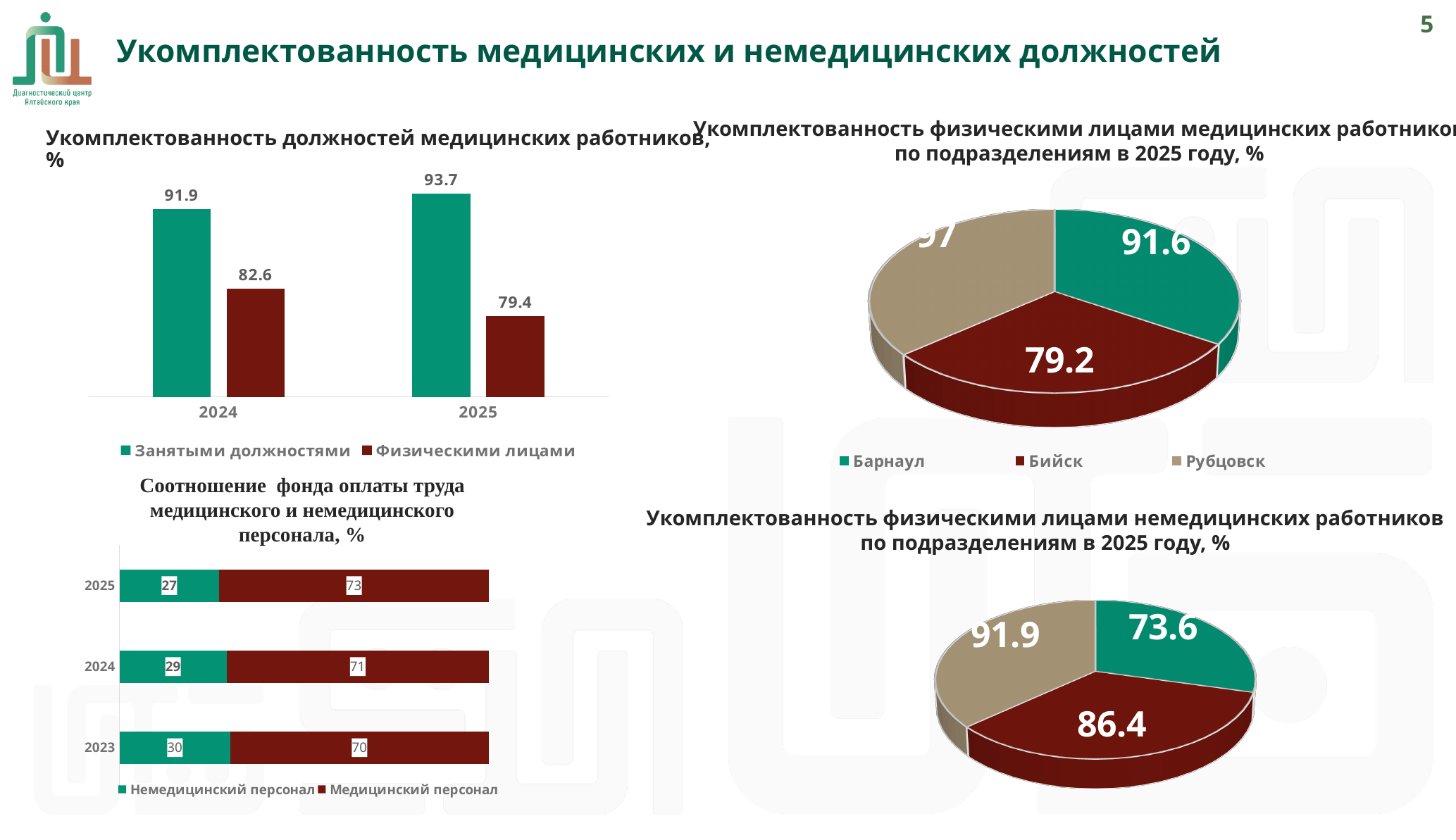
In the top-right pie chart on medical workers by subdivision in 2025, which is larger, Барнаул or Бийск? Барнаул In the top-left chart 'Укомплектованность должностей медицинских работников, %', what is the value for 'Физическими лицами' in 2024? 82.6 In the top-left chart 'Укомплектованность должностей медицинских работников, %', what is the difference between 'Занятыми должностями' and 'Физическими лицами' in 2025? 14.3 How many series does the legend of the top-left chart 'Укомплектованность должностей медицинских работников, %' list? 2 In the bottom-left chart 'Соотношение фонда оплаты труда медицинского и немедицинского персонала, %', what is the total of the stacked bar for 2024? 100 In the top-left chart 'Укомплектованность должностей медицинских работников, %', what is the value for 'Занятыми должностями' in 2025? 93.7 In the bottom-left chart 'Соотношение фонда оплаты труда медицинского и немедицинского персонала, %', what is the value for 'Медицинский персонал' in 2023? 70 In the top-right pie chart on medical workers by subdivision in 2025, what is the value for Бийск? 79.2 What kind of chart is the bottom-left chart 'Соотношение фонда оплаты труда медицинского и немедицинского персонала, %'? stacked bar chart In the top-left chart 'Укомплектованность должностей медицинских работников, %', did the value for 'Физическими лицами' rise or fall from 2024 to 2025? fall